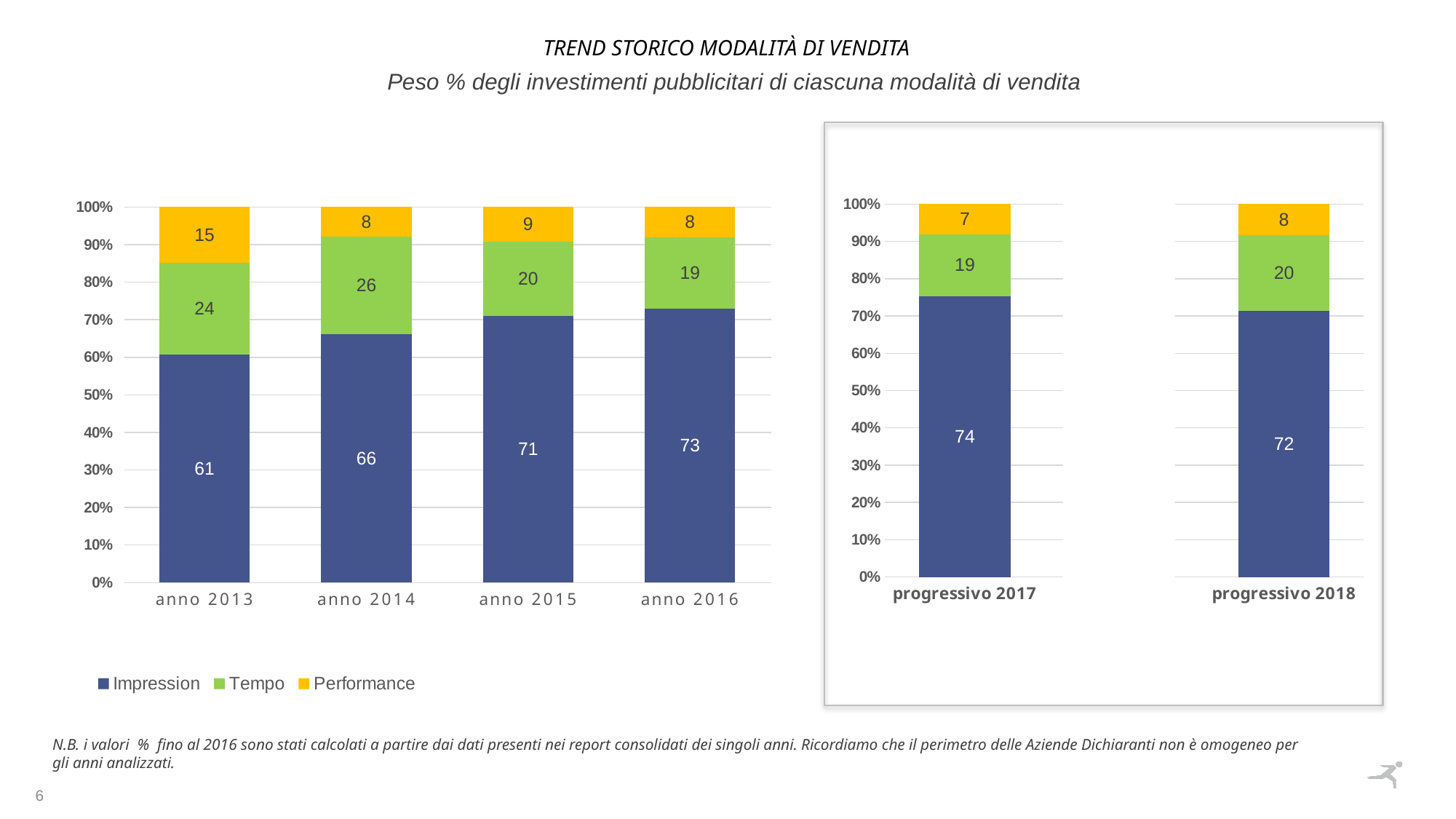
How many series does the legend list? 3 In the left chart (anno 2013–2016), what is the difference between the Impression values for anno 2016 and anno 2013? 12 In the left chart (anno 2013–2016), which year has the highest Impression value? anno 2016 In the right chart (progressivo 2017–2018), which is larger, the Tempo value for progressivo 2017 or for progressivo 2018? progressivo 2018 In the right chart (progressivo 2017–2018), what is the Impression value for progressivo 2017? 74 In the left chart (anno 2013–2016), does the Impression value rise or fall from anno 2013 to anno 2016? rise In the left chart (anno 2013–2016), which year has the lowest Performance value? anno 2014 and anno 2016 (both 8) In the left chart (anno 2013–2016), what is the Performance value for anno 2013? 15 In the right chart (progressivo 2017–2018), what is the Performance value for progressivo 2018? 8 What kind of chart is the left chart (anno 2013–2016)? stacked bar chart In the left chart (anno 2013–2016), what is the Tempo value for anno 2014? 26 In the left chart (anno 2013–2016), what is the Impression value for anno 2013? 61